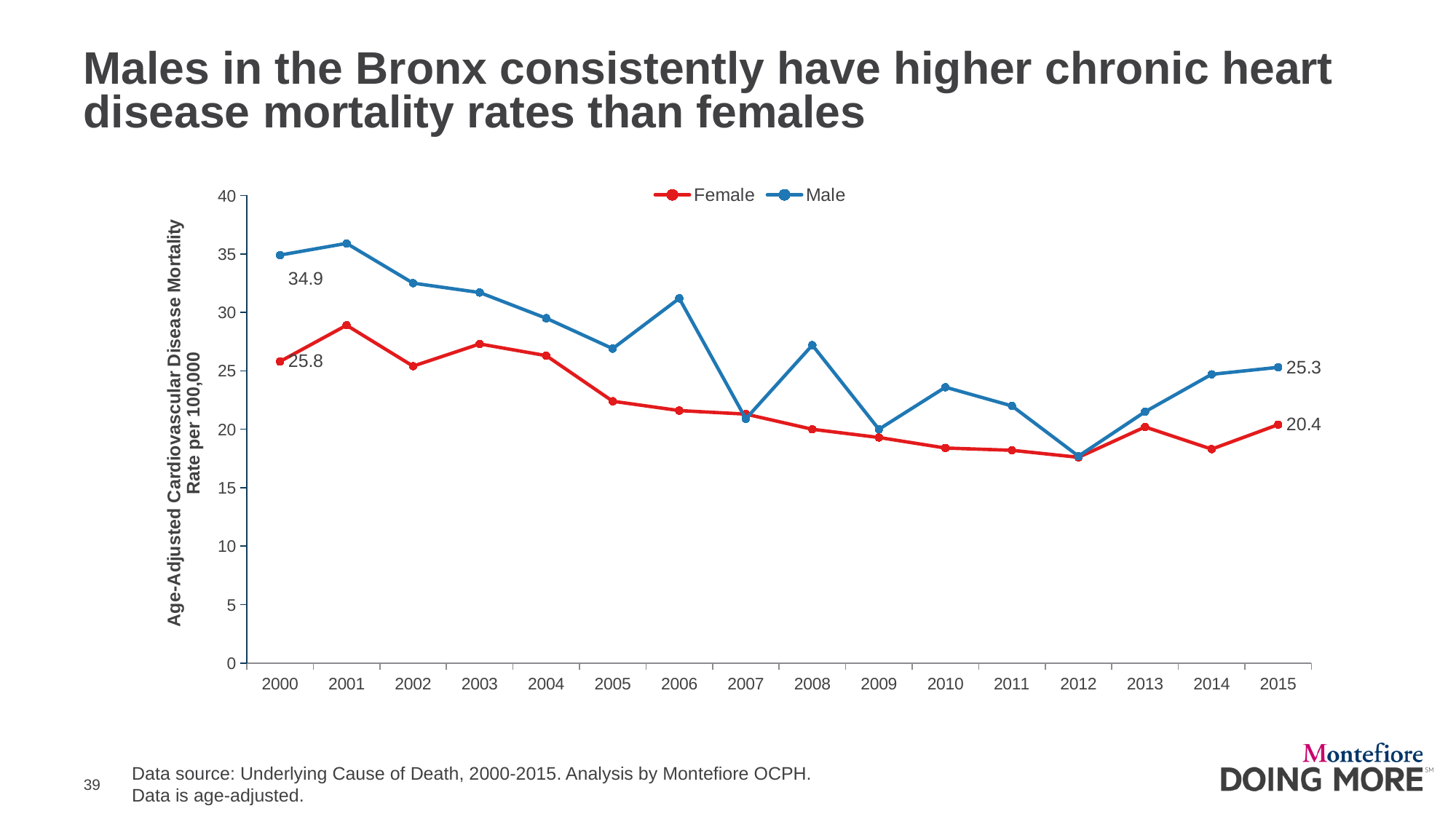
In 2006, which series has the higher value, Male or Female? Male How many years are shown on the x axis? 16 How many series does the legend list? 2 What kind of chart is shown on the slide? line chart What is the Female mortality rate in 2015? 20.4 By how much did the Male mortality rate decrease from 2000 to 2015? 9.6 Is the Female value for 2012 greater or less than 20? less Does the Female mortality rate overall rise or fall from 2000 to 2015? fall What is the difference between the Male and Female mortality rates in 2015? 4.9 What is the Female chronic heart disease mortality rate in 2000? 25.8 What is the Male mortality rate in 2015? 25.3 What is the Male chronic heart disease mortality rate in 2000? 34.9